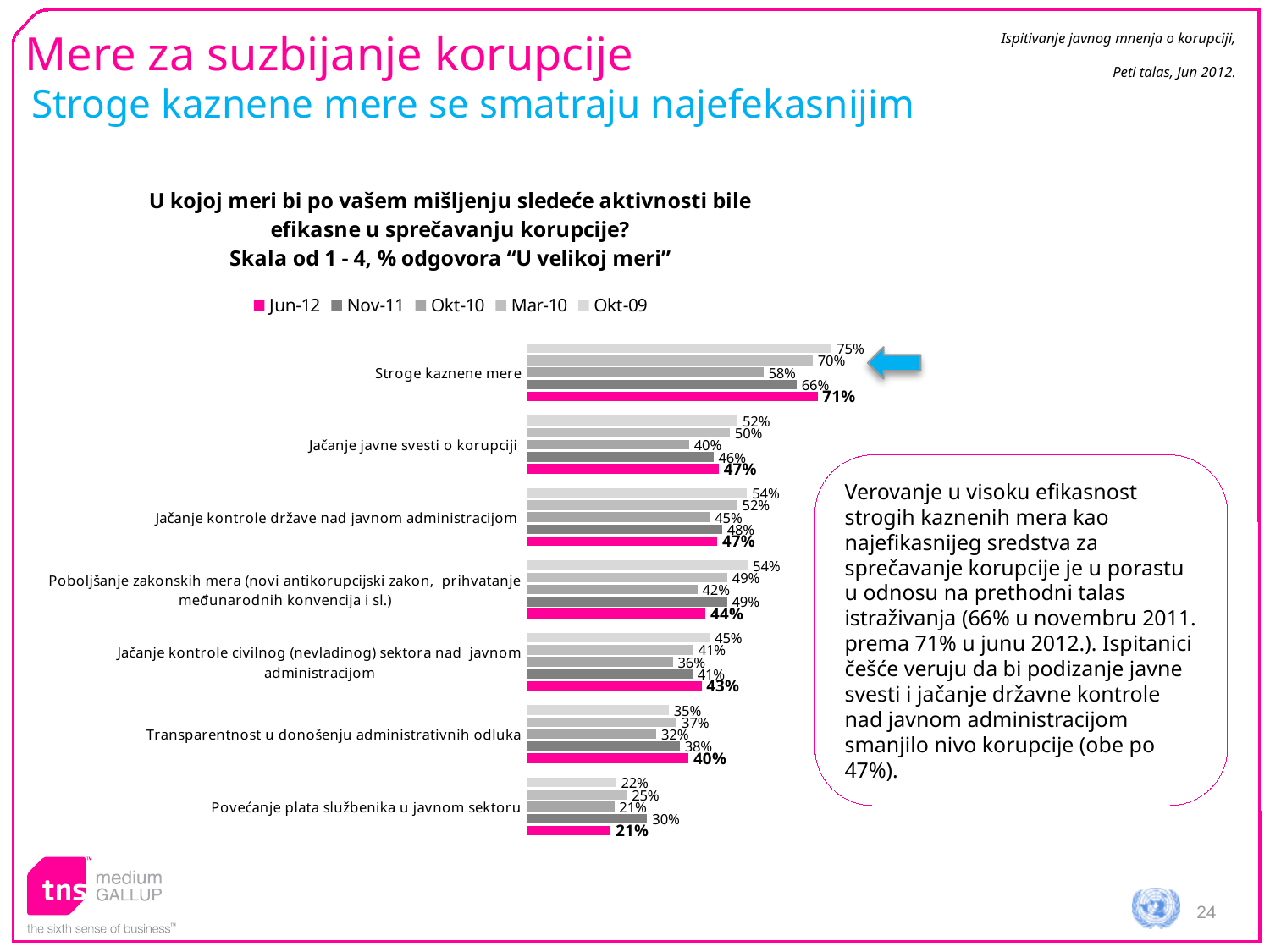
How many categories (activities) are plotted in the chart? 7 What is the Jun-12 value for 'Stroge kaznene mere'? 71% What kind of chart is shown on the slide? bar chart What is the difference between the Jun-12 and Nov-11 values for 'Stroge kaznene mere'? 5% Which category has the lowest Jun-12 value? Povećanje plata službenika u javnom sektoru Which is larger for 'Poboljšanje zakonskih mera': the Jun-12 value or the Nov-11 value? Nov-11 What is the Jun-12 value for 'Povećanje plata službenika u javnom sektoru'? 21% What is the Nov-11 value for 'Stroge kaznene mere'? 66% What is the Jun-12 value for 'Transparentnost u donošenju administrativnih odluka'? 40% Which category has the highest Jun-12 value? Stroge kaznene mere How many series does the legend list? 5 Which series is shown in pink in the legend? Jun-12